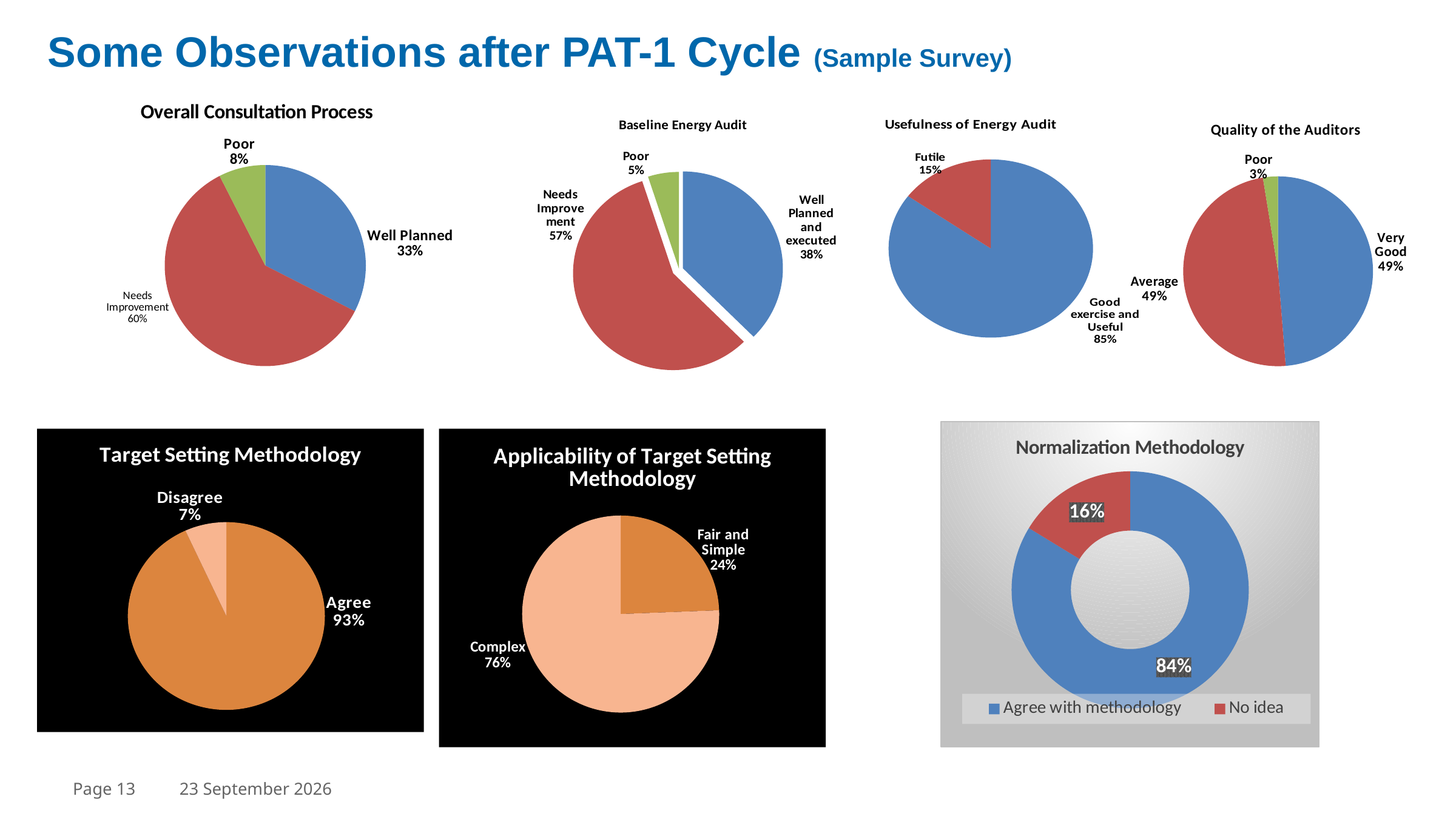
In the "Overall Consultation Process" chart, what share of respondents said Needs Improvement? 60% In the "Usefulness of Energy Audit" chart, which category has the largest share? Good exercise and Useful How many entries does the legend of the "Normalization Methodology" chart list? 2 How many categories are shown in the "Quality of the Auditors" chart? 3 In the "Target Setting Methodology" chart, which is larger, Agree or Disagree? Agree In the "Baseline Energy Audit" chart, what is the share for Well Planned and executed? 38% In the "Quality of the Auditors" chart, what share of respondents rated the auditors Poor? 3% In the "Baseline Energy Audit" chart, what is the difference between the Needs Improvement share and the Well Planned and executed share? 19% In the "Overall Consultation Process" chart, which category has the smallest share? Poor What kind of chart is the "Normalization Methodology" chart? Doughnut chart In the "Applicability of Target Setting Methodology" chart, what share of respondents found the methodology Complex? 76% In the "Normalization Methodology" chart, what share of respondents answered No idea? 16%